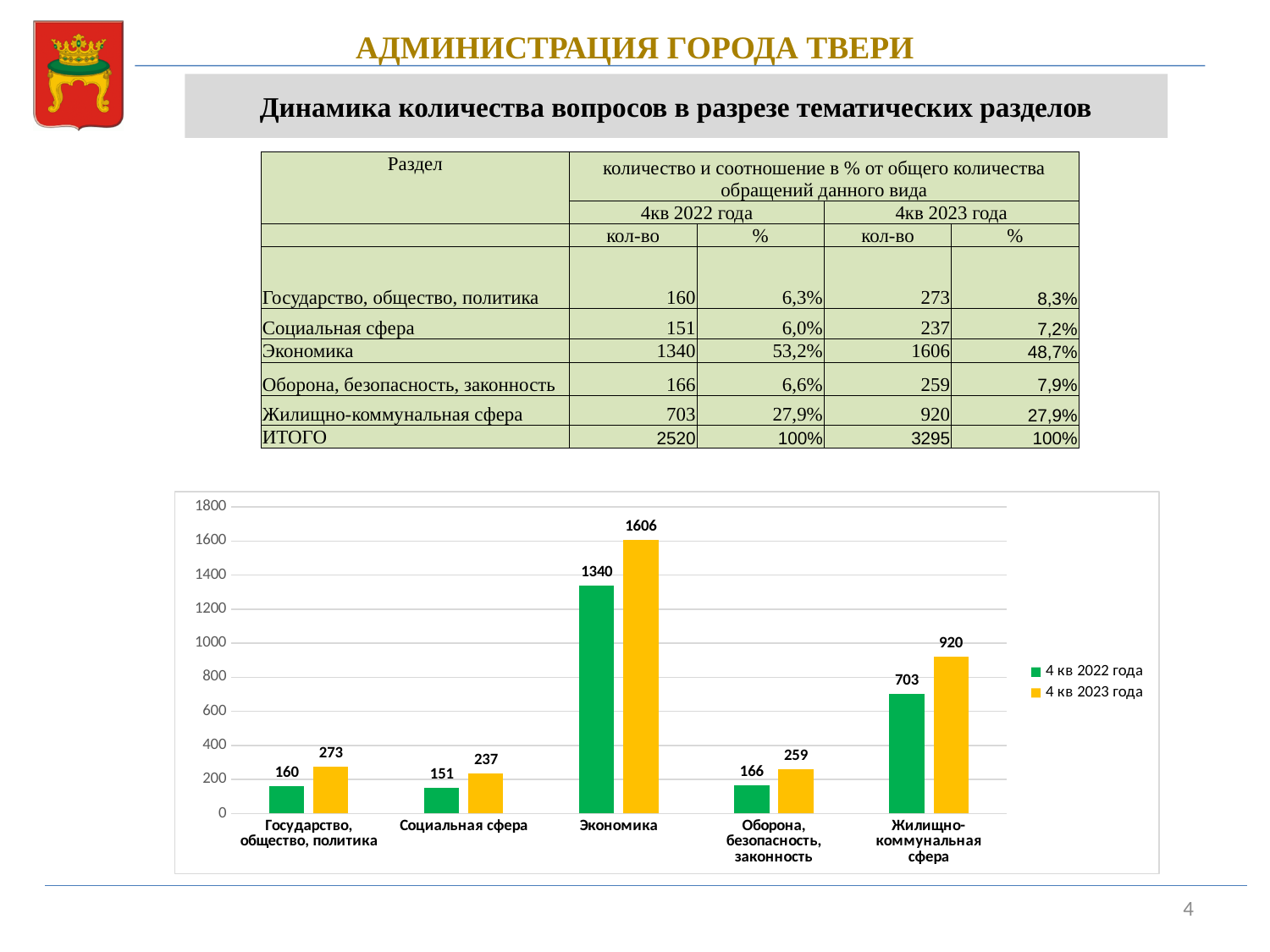
What is the value for Экономика in the 4 кв 2023 года series? 1606 What is the difference between the 4 кв 2023 года and 4 кв 2022 года values for Экономика? 266 What is the value for Социальная сфера in the 4 кв 2023 года series? 237 What is the difference between the 4 кв 2023 года and 4 кв 2022 года values for Жилищно-коммунальная сфера? 217 Which colour represents the 4 кв 2023 года series in the chart? Yellow Which category has the highest value in the 4 кв 2022 года series? Экономика What kind of chart is shown on the slide? Bar chart Which is larger: the 4 кв 2022 года value for Оборона, безопасность, законность or the 4 кв 2022 года value for Государство, общество, политика? Оборона, безопасность, законность Which category has the lowest value in the 4 кв 2023 года series? Социальная сфера How many categories are shown on the x axis of the chart? 5 How many series does the chart legend list? 2 What is the value for Жилищно-коммунальная сфера in the 4 кв 2022 года series? 703